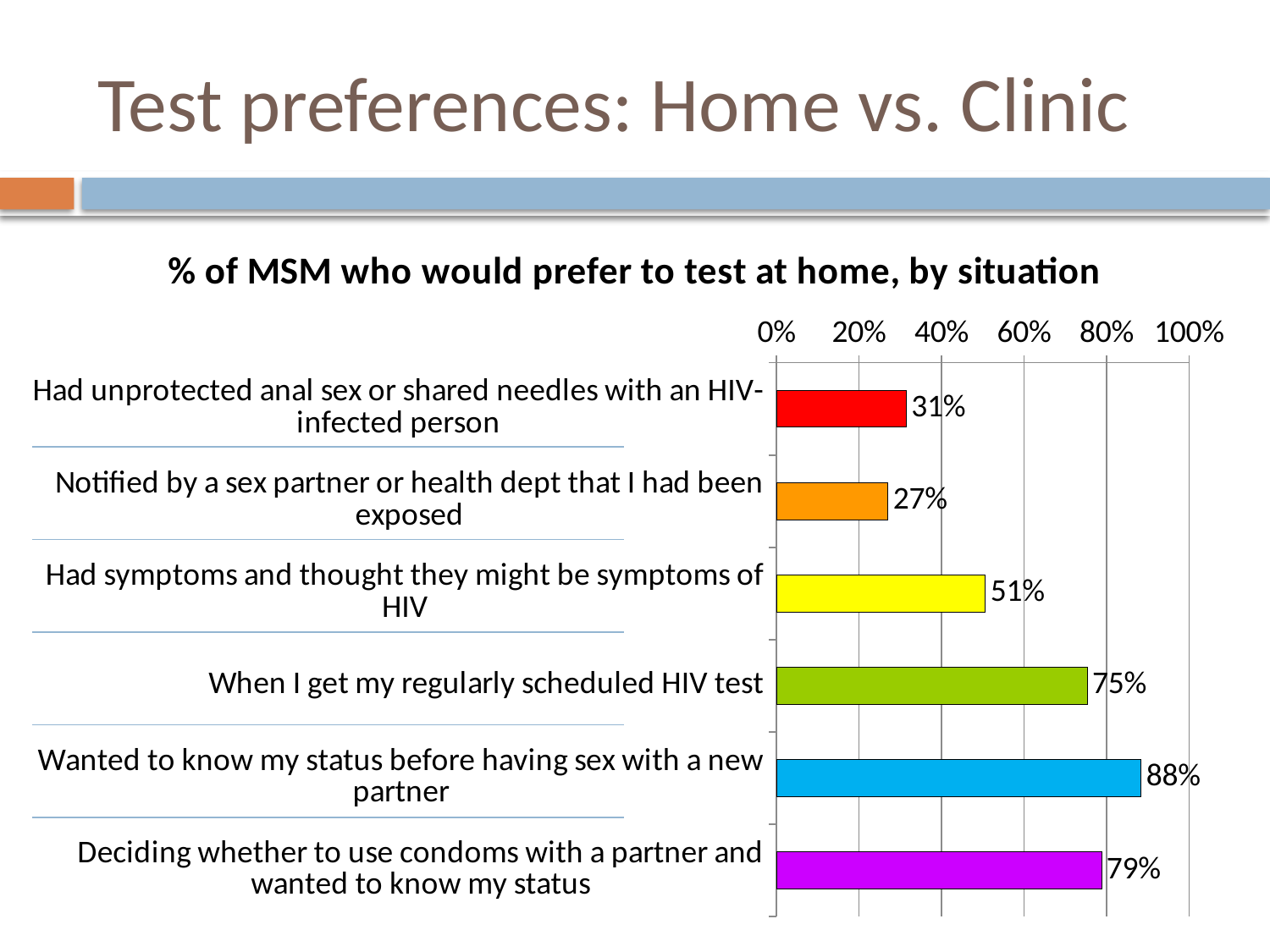
What is the difference between the value for 'Wanted to know my status before having sex with a new partner' and the value for 'Deciding whether to use condoms with a partner and wanted to know my status'? 9% What colour is the bar for 'Wanted to know my status before having sex with a new partner'? Blue Which situation has the lowest percentage of MSM preferring to test at home? Notified by a sex partner or health dept that I had been exposed How many situations are shown in the chart? 6 What is the value for 'Notified by a sex partner or health dept that I had been exposed'? 27% What is the title of the chart? % of MSM who would prefer to test at home, by situation Is the value for 'When I get my regularly scheduled HIV test' greater or less than 60%? greater What kind of chart is shown on the slide? Bar chart What is the value for 'Had symptoms and thought they might be symptoms of HIV'? 51% Which is larger: the value for 'Had unprotected anal sex or shared needles with an HIV-infected person' or the value for 'Had symptoms and thought they might be symptoms of HIV'? Had symptoms and thought they might be symptoms of HIV Which situation has the highest percentage of MSM preferring to test at home? Wanted to know my status before having sex with a new partner What percentage of MSM would prefer to test at home when they get their regularly scheduled HIV test? 75%